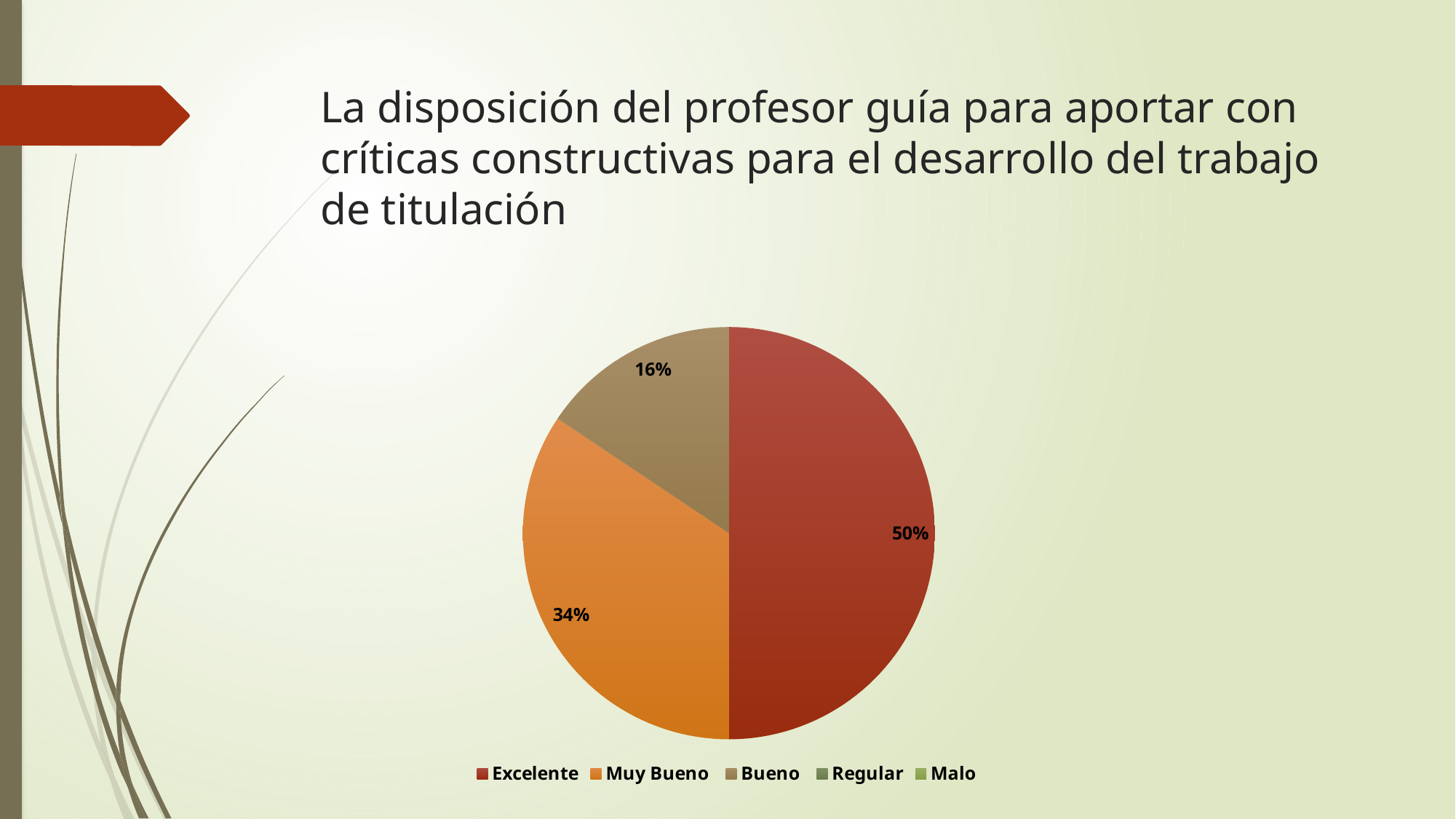
What is the difference in percentage points between the Muy Bueno slice and the Bueno slice? 18 How many slices with printed percentage labels are visible in the pie? 3 Among the slices with printed values, which category has the smallest slice? Bueno What kind of chart is shown on the slide? pie chart Which category has the largest slice of the pie? Excelente What percentage of the pie corresponds to Bueno? 16% What percentage of the pie corresponds to Muy Bueno? 34% What colour is the Excelente slice of the pie? red How many categories does the legend list? 5 What is the difference in percentage points between the Excelente slice and the Muy Bueno slice? 16 Which slice is larger, Muy Bueno or Bueno? Muy Bueno What percentage of the pie corresponds to Excelente? 50%